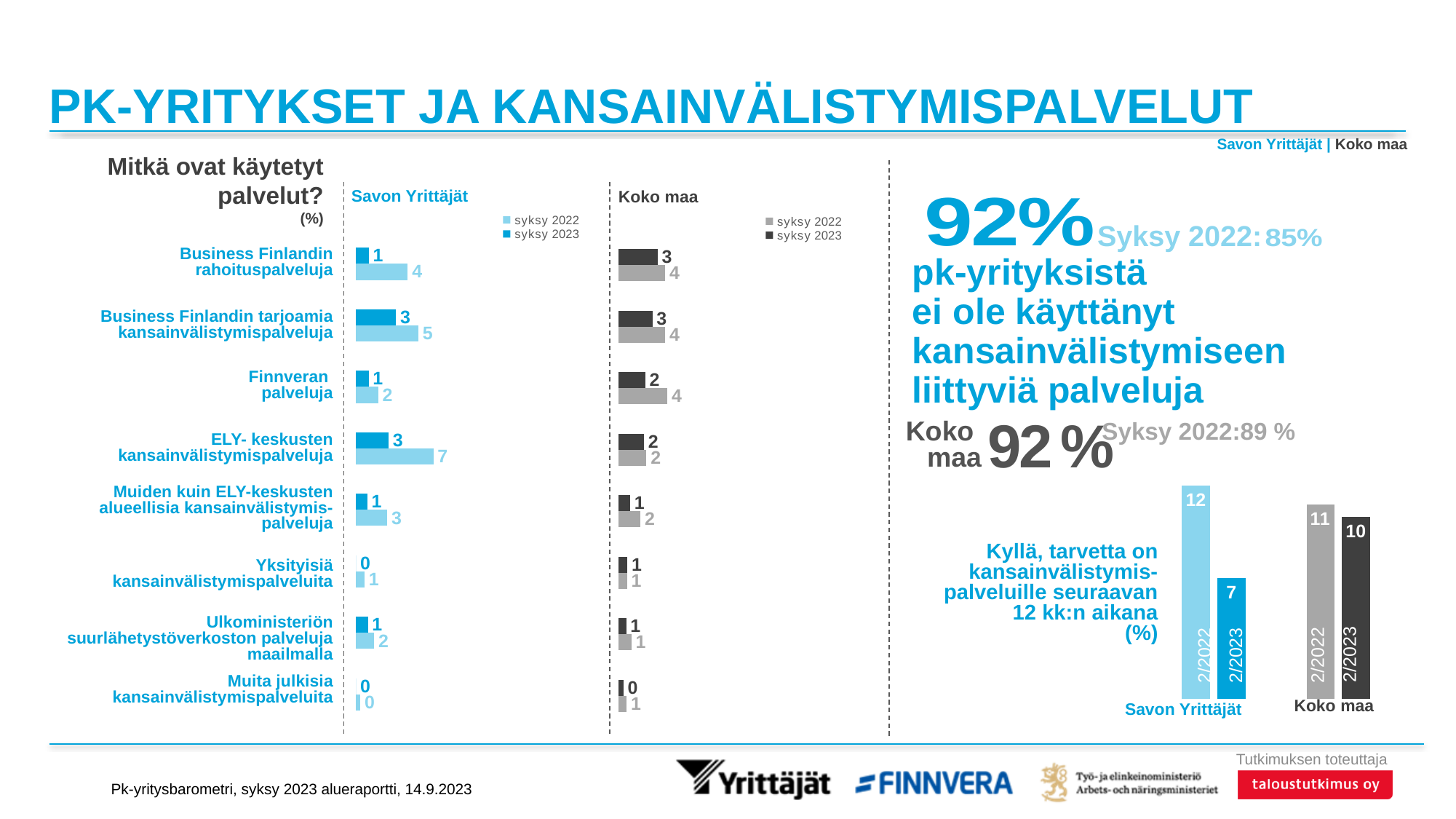
In the Koko maa chart, which is larger for Finnveran palveluja: the syksy 2022 value or the syksy 2023 value? syksy 2022 How many series does the legend of the Koko maa chart list? 2 In the chart at the bottom right (Kyllä, tarvetta on kansainvälistymispalveluille seuraavan 12 kk:n aikana), what is the difference between the 2/2022 and 2/2023 values for Koko maa? 1 In the Savon Yrittäjät chart, which category has the highest syksy 2022 value? ELY- keskusten kansainvälistymispalveluja In the Koko maa chart, what is the syksy 2022 value for Finnveran palveluja? 4 What kind of chart is the Savon Yrittäjät chart on the left? Bar chart How many categories does the Savon Yrittäjät chart show? 8 In the Koko maa chart, what is the syksy 2023 value for Business Finlandin rahoituspalveluja? 3 In the Savon Yrittäjät chart, what is the syksy 2023 value for Business Finlandin tarjoamia kansainvälistymispalveluja? 3 In the chart at the bottom right (Kyllä, tarvetta on kansainvälistymispalveluille seuraavan 12 kk:n aikana), what is the 2/2023 value for Savon Yrittäjät? 7 In the Savon Yrittäjät chart, what is the syksy 2022 value for ELY- keskusten kansainvälistymispalveluja? 7 In the Savon Yrittäjät chart, what is the difference between the syksy 2022 and syksy 2023 values for ELY- keskusten kansainvälistymispalveluja? 4